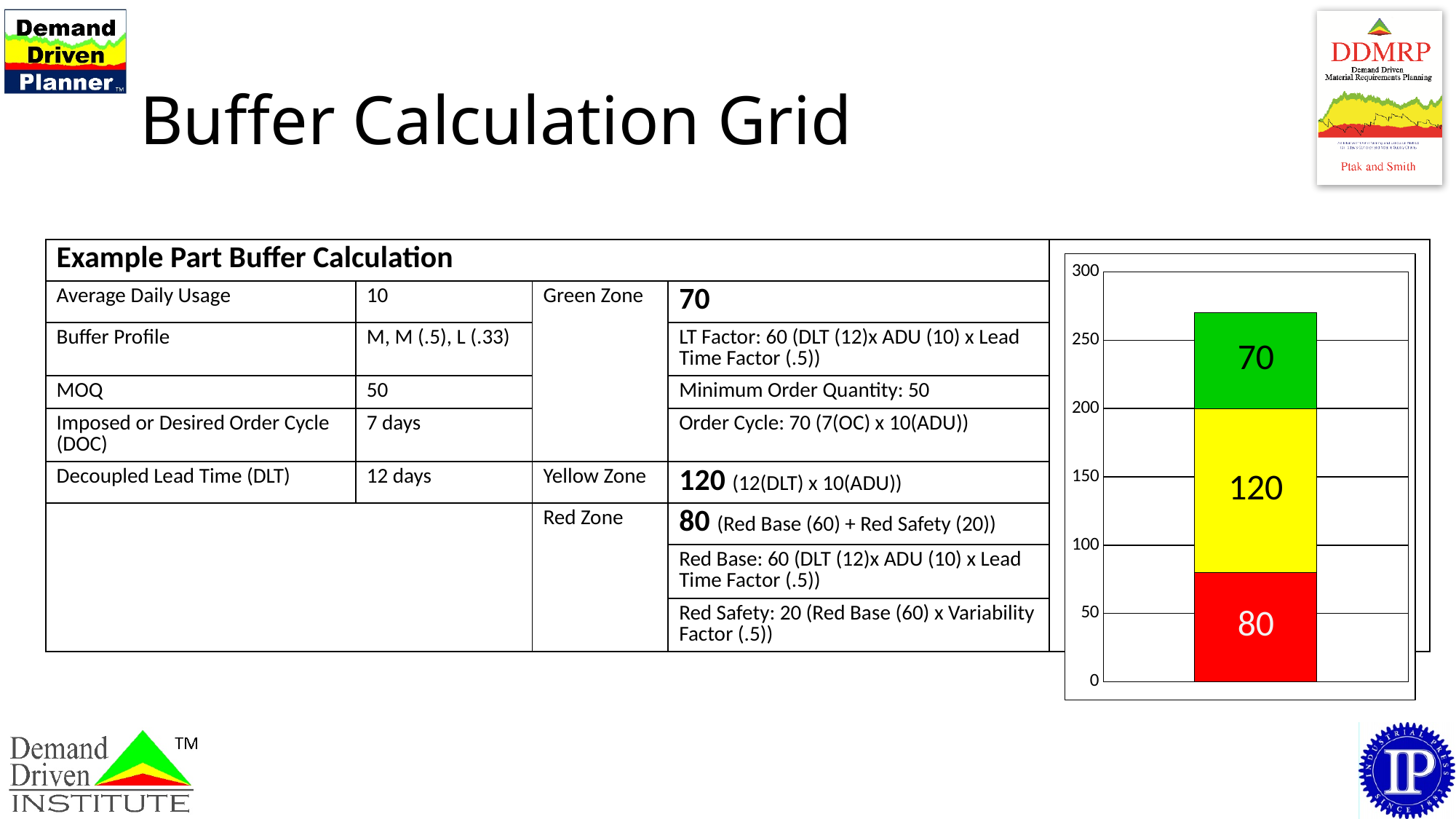
What is the value of the yellow segment of the bar? 120 What is the total height of the stacked bar? 270 What is the difference between the red segment and the green segment? 10 Which segment of the bar has the smallest value? green (70) What is the value of the green segment of the bar? 70 How many segments make up the stacked bar? 3 Which segment of the bar has the largest value? yellow (120) Which is larger, the red segment or the green segment? red What is the value of the red segment of the bar? 80 What kind of chart is shown on the right of the slide? stacked bar chart What is the difference between the yellow segment and the red segment? 40 What is the maximum value shown on the vertical axis of the chart? 300